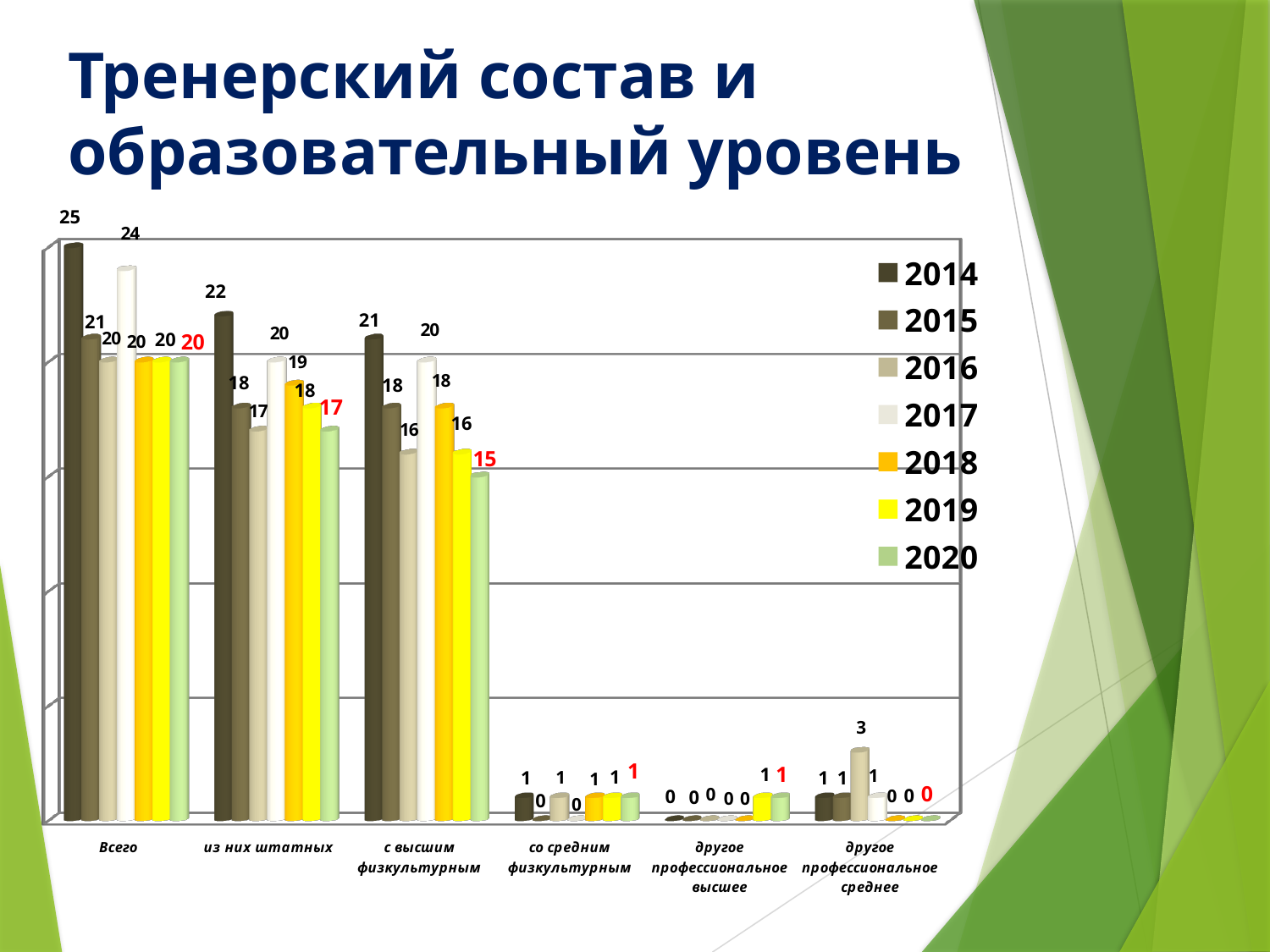
What kind of chart is shown on the slide? Bar chart What is the value for 2020 in the "с высшим физкультурным" category? 15 What is the difference between the 2014 and 2020 values in the "Всего" category? 5 What is the value for 2019 in the "другое профессиональное высшее" category? 1 Which is larger in the "из них штатных" category: the value for 2017 or the value for 2018? 2017 Which year has the highest value in the "из них штатных" category? 2014 Which year has the lowest value in the "с высшим физкультурным" category? 2020 What is the value for 2016 in the "другое профессиональное среднее" category? 3 What is the value for 2017 in the "Всего" category? 24 How many series does the legend list? 7 What is the value for 2014 in the "Всего" category? 25 How many categories are shown on the x axis? 6